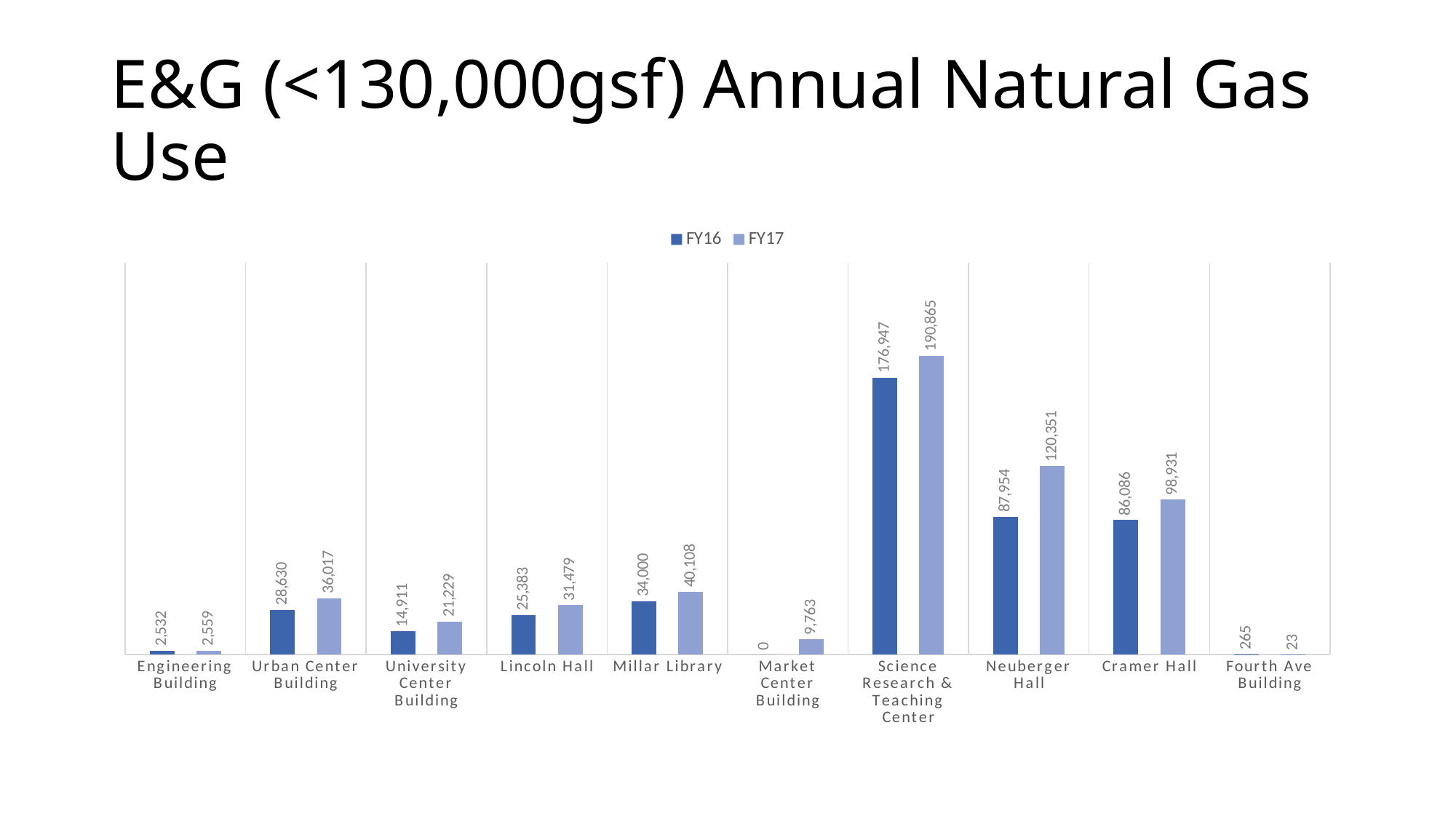
Which is larger for Millar Library, the FY16 value or the FY17 value? FY17 How many buildings are shown on the x axis? 10 What is the title of the slide? E&G (<130,000gsf) Annual Natural Gas Use What is the FY17 value for Neuberger Hall? 120,351 What is the FY16 value for Fourth Ave Building? 265 What kind of chart is shown on the slide? Bar chart How many series does the legend list? 2 What is the FY17 value for Market Center Building? 9,763 What is the difference between the FY17 and FY16 values for Cramer Hall? 12,845 Which building has the lowest FY16 value? Market Center Building What is the FY16 value for Lincoln Hall? 25,383 Which building has the highest FY17 value? Science Research & Teaching Center